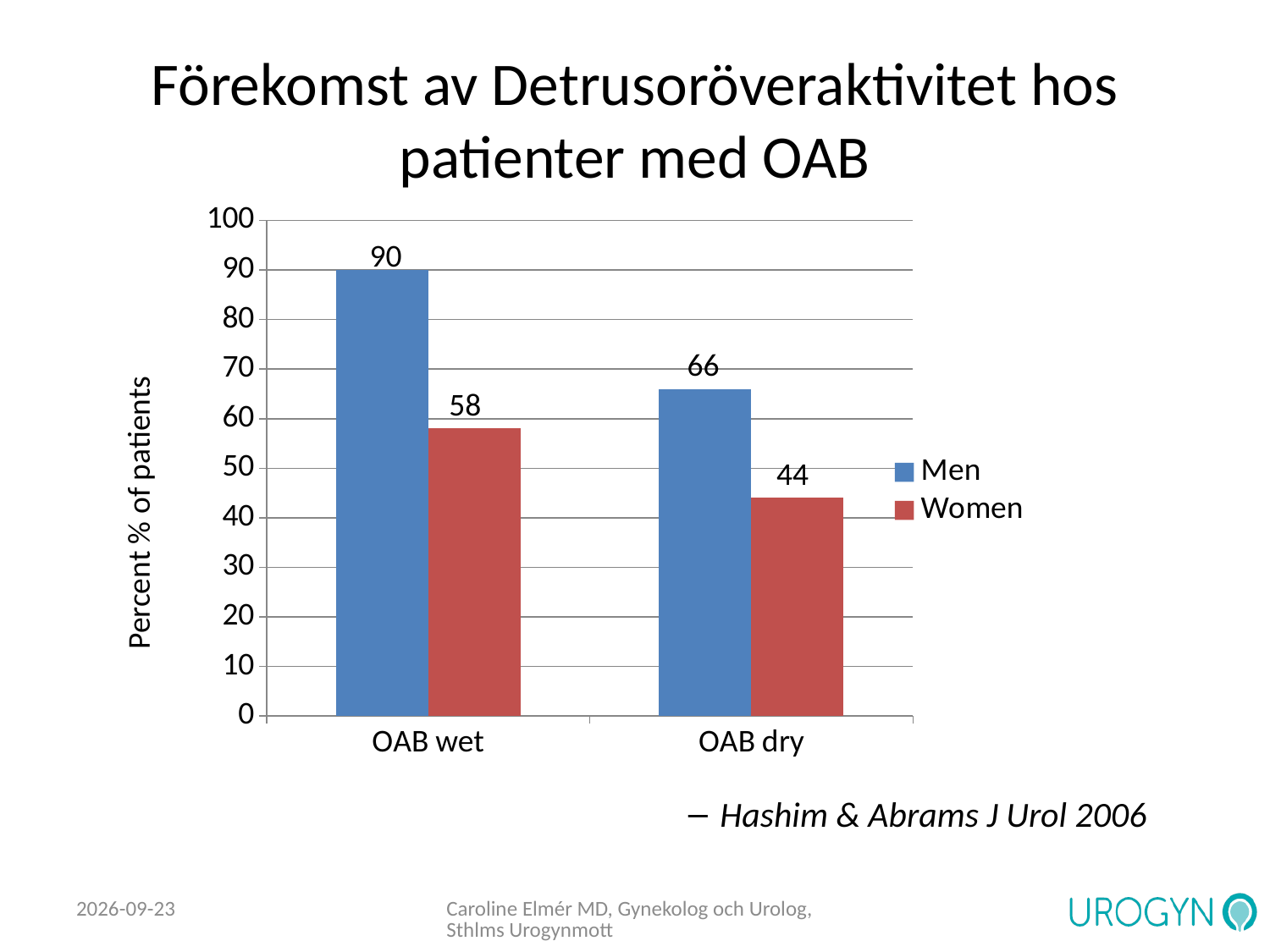
How many categories are shown on the x axis? 2 What is the value for Men in the OAB wet category? 90 What is the difference between the Men and Women values in the OAB wet category? 32 Which is larger: the Men value for OAB dry or the Women value for OAB wet? Men value for OAB dry How many series does the legend list? 2 What is the difference between the Men values for OAB wet and OAB dry? 24 What is the value for Women in the OAB dry category? 44 What is the label of the y axis? Percent % of patients What is the value for Women in the OAB wet category? 58 Which category has the lowest value for Women? OAB dry What kind of chart is shown on the slide? Bar chart Which category has the highest value for Men? OAB wet